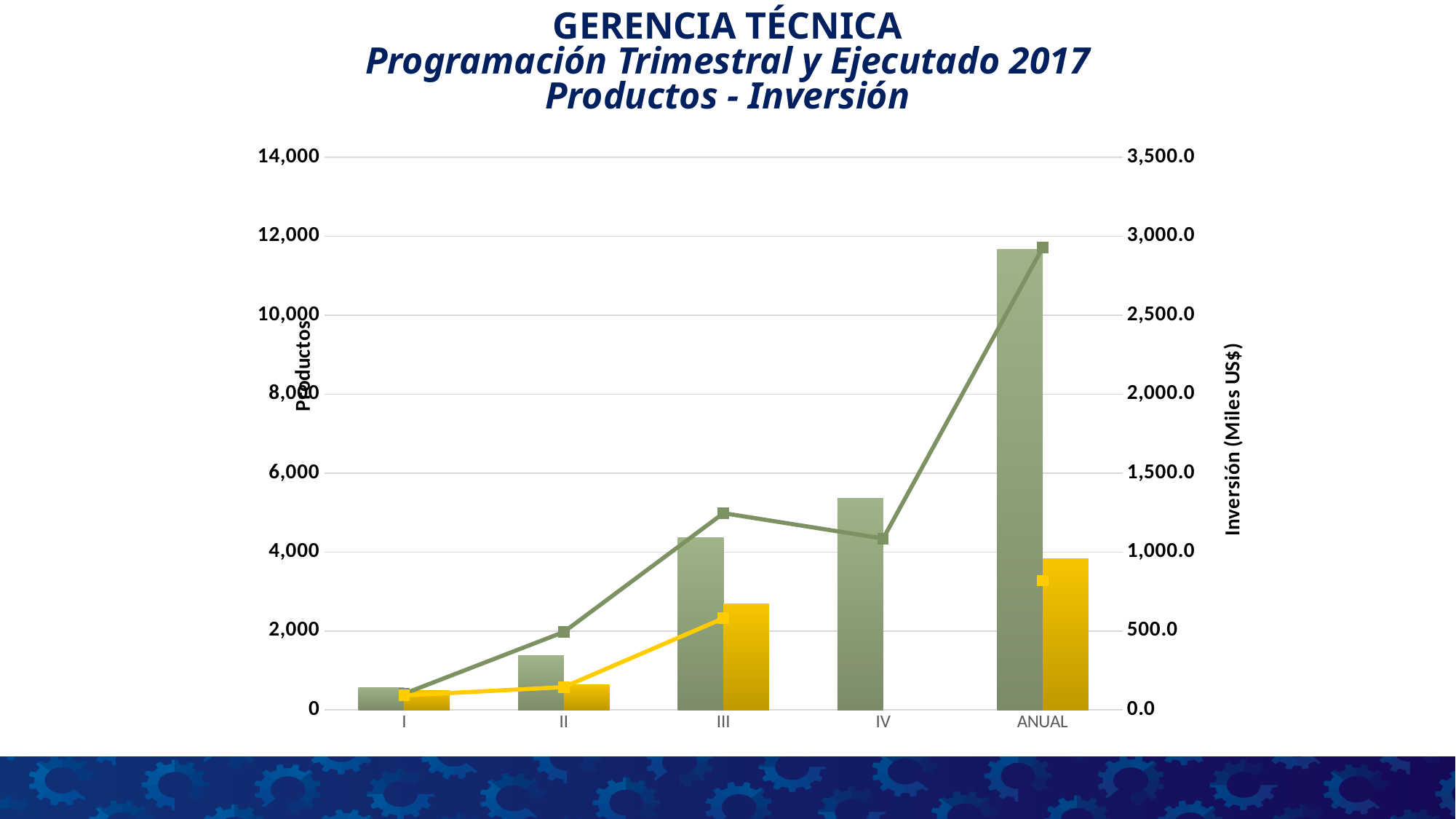
Which is larger, the green bar for III or the green bar for IV? IV How many categories are shown on the x axis? 5 Which category has the shortest green bar? I Is the green bar for IV greater or less than 6,000 on the left axis? less Which category has the tallest green bar? ANUAL Do the green bars rise or fall from category I to category IV? rise Is the yellow bar for III greater or less than 2,000 on the left axis? greater Is the green line point for ANUAL greater or less than 2,500.0 on the right axis? greater Which category has no yellow bar? IV What is the title of the right-hand vertical axis? Inversión (Miles US$) What kind of chart is shown on the slide? A combined bar and line chart